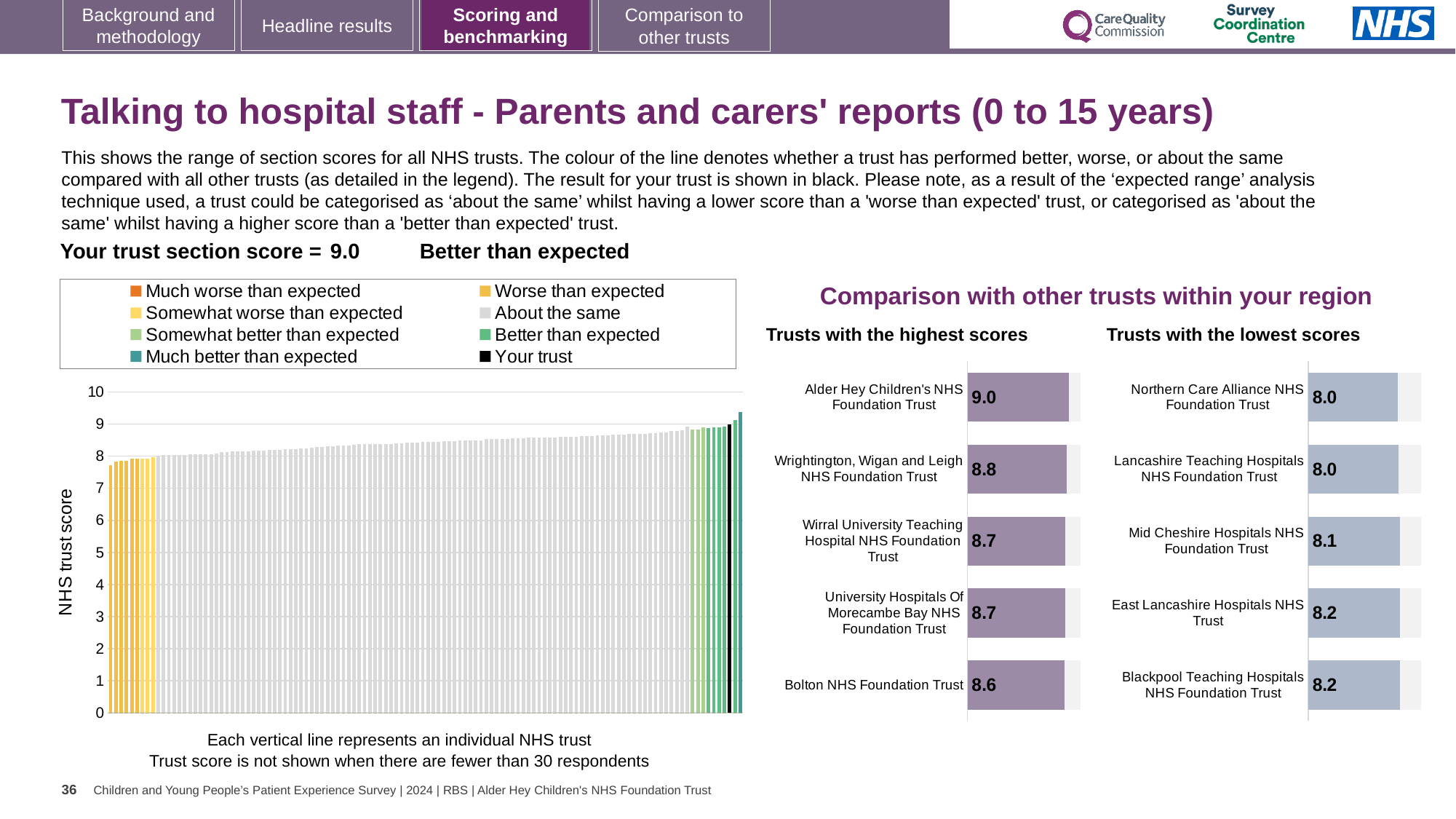
In the large chart on the left, do the bar values rise or fall from left to right? Rise How many trusts are shown in the 'Trusts with the highest scores' chart? 5 In the 'Trusts with the lowest scores' chart, what is the score for Mid Cheshire Hospitals NHS Foundation Trust? 8.1 In the 'Trusts with the highest scores' chart, which trust has the highest score? Alder Hey Children's NHS Foundation Trust How many entries does the legend of the large chart on the left list? 8 In the 'Trusts with the lowest scores' chart, which has the higher score: East Lancashire Hospitals NHS Trust or Northern Care Alliance NHS Foundation Trust? East Lancashire Hospitals NHS Trust In the 'Trusts with the lowest scores' chart, what is the difference between the scores of Blackpool Teaching Hospitals NHS Foundation Trust and Lancashire Teaching Hospitals NHS Foundation Trust? 0.2 What is the y-axis label of the large chart on the left? NHS trust score What kind of chart is the large chart on the left showing all NHS trusts? Bar chart In the 'Trusts with the highest scores' chart, what is the score for Bolton NHS Foundation Trust? 8.6 In the 'Trusts with the highest scores' chart, what is the difference between the scores of Alder Hey Children's NHS Foundation Trust and Bolton NHS Foundation Trust? 0.4 In the large chart on the left, what is the section score for your trust (the black bar)? 9.0